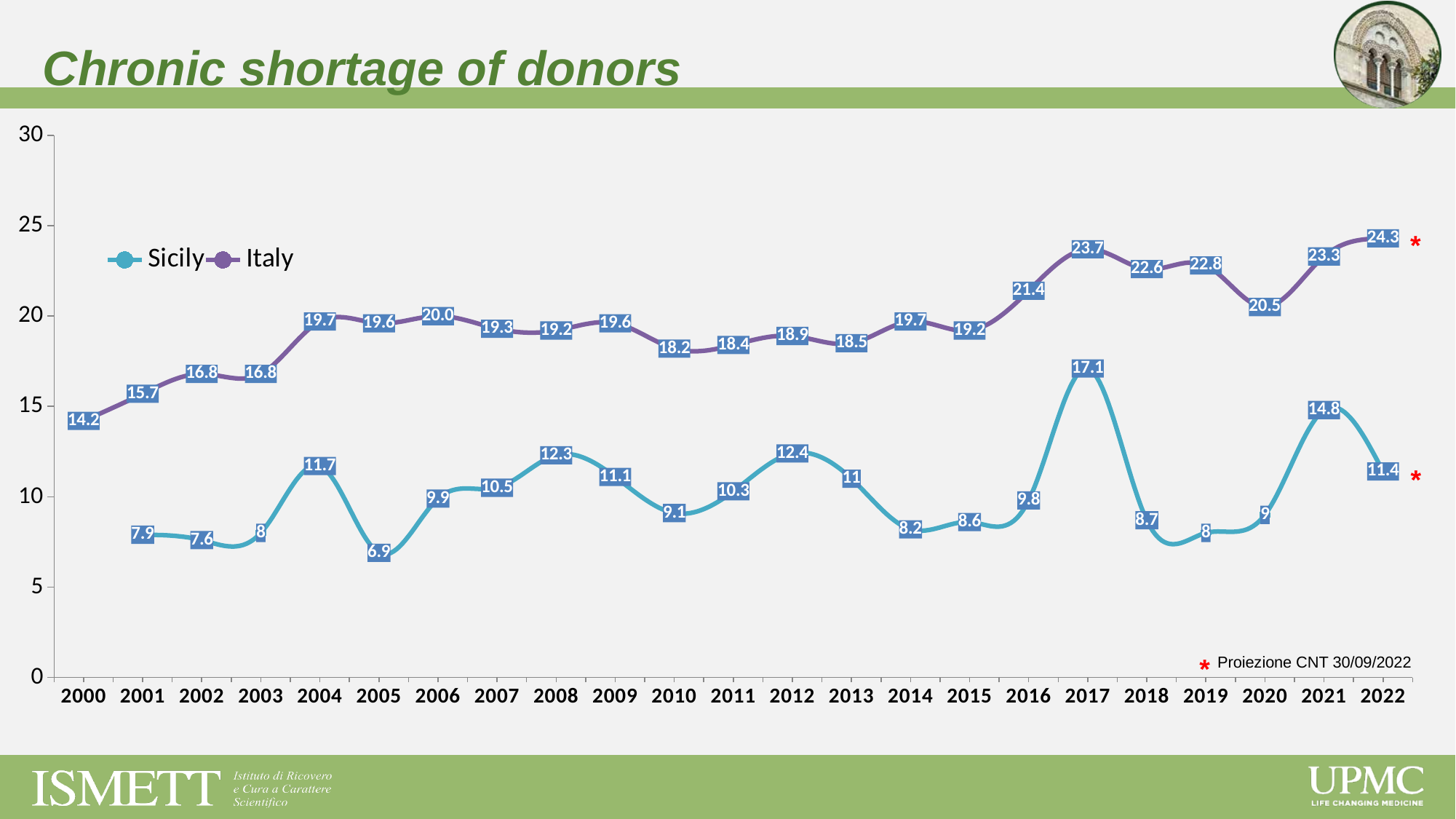
How many series does the legend list? 2 In which year does the Sicily series reach its highest value? 2017 What is the value for Sicily in 2005? 6.9 What kind of chart is shown on the slide? Line chart What is the value for Sicily in 2017? 17.1 What is the value for Italy in 2000? 14.2 In which year does the Italy series reach its highest value? 2022 In which year does the Sicily series reach its lowest value? 2005 How many years are shown on the x axis? 23 Which series has the larger value in 2017, Sicily or Italy? Italy What is the difference between the Italy and Sicily values in 2022? 12.9 What is the value for Italy in 2022? 24.3